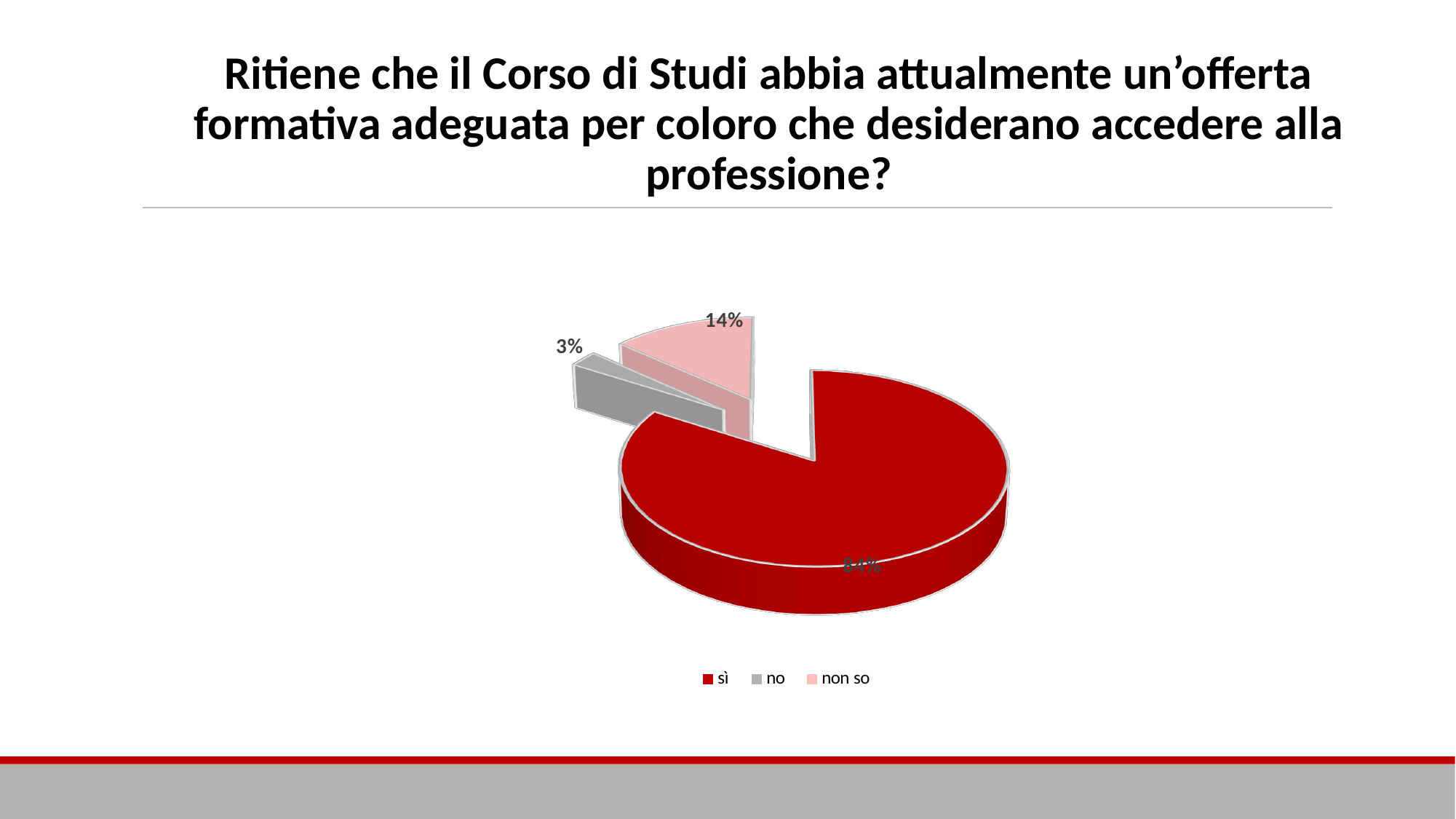
What share of the pie does "non so" represent? 14% What share of the pie does "sì" represent? 84% What is the difference in percentage points between the "non so" slice and the "no" slice? 11 Which is larger, the slice for "no" or the slice for "non so"? non so How many categories does the pie chart have? 3 How many entries does the legend list? 3 What colour is the slice for "no"? grey What share of the pie does "no" represent? 3% What kind of chart is shown on the slide? pie chart Which category has the smallest slice of the pie? no What is the difference in percentage points between the "sì" slice and the "non so" slice? 70 Which category has the largest slice of the pie? sì